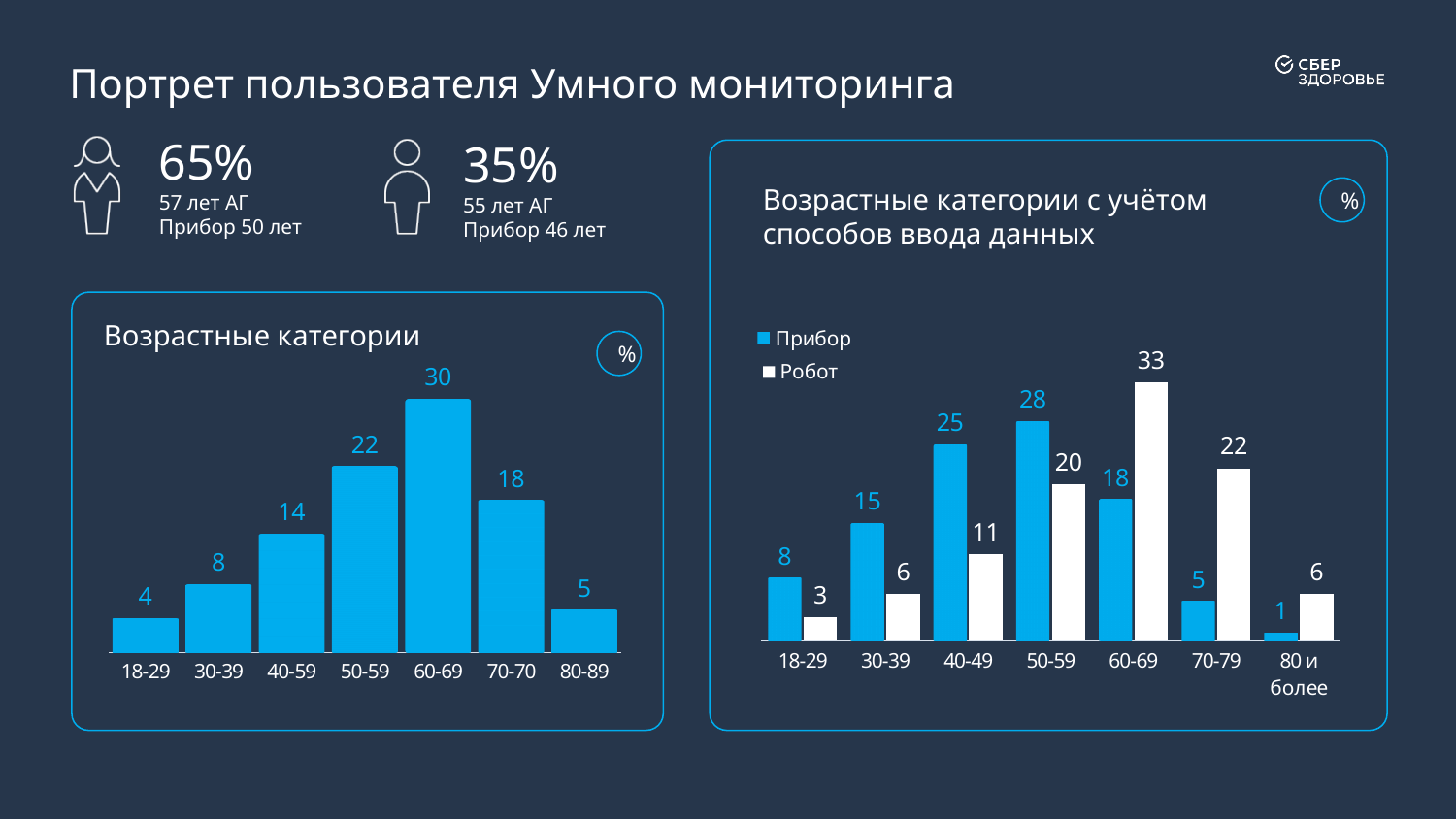
In the chart titled 'Возрастные категории с учётом способов ввода данных', what is the value of Робот for the 60-69 category? 33 In the chart titled 'Возрастные категории с учётом способов ввода данных', what colour are the Прибор bars? Blue How many age categories are shown in the chart titled 'Возрастные категории'? 7 In the chart titled 'Возрастные категории с учётом способов ввода данных', what is the difference between Робот and Прибор for the 50-59 category? 8 In the chart titled 'Возрастные категории с учётом способов ввода данных', what is the value of Прибор for the 40-49 category? 25 In the chart titled 'Возрастные категории с учётом способов ввода данных', which is larger for the 70-79 category: Прибор or Робот? Робот In the chart titled 'Возрастные категории', what is the difference between the values for 50-59 and 30-39? 14 In the chart titled 'Возрастные категории', what is the value for the 60-69 category? 30 What type of chart is the chart titled 'Возрастные категории'? Bar chart In the chart titled 'Возрастные категории', which age category has the lowest value? 18-29 In the chart titled 'Возрастные категории с учётом способов ввода данных', which category has the highest Прибор value? 50-59 How many series does the legend list in the chart titled 'Возрастные категории с учётом способов ввода данных'? 2